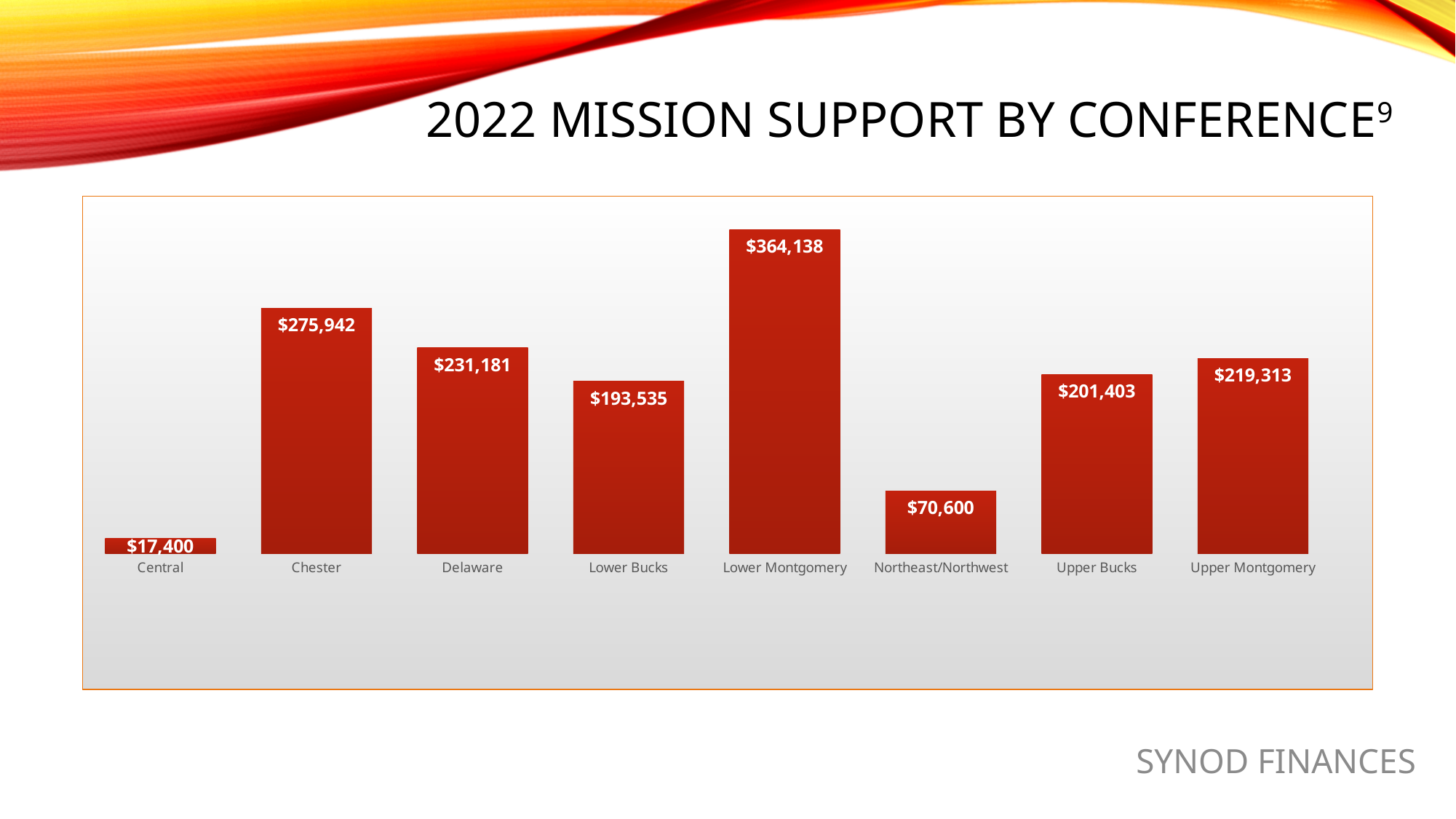
What is the 2022 mission support value for Upper Bucks? $201,403 What is the title of the slide containing the chart? 2022 Mission Support by Conference What is the difference in mission support between Delaware and Lower Bucks? $37,646 Which has higher mission support, Upper Montgomery or Upper Bucks? Upper Montgomery Which conference has the highest 2022 mission support? Lower Montgomery What is the 2022 mission support value for Lower Montgomery? $364,138 How many conferences are shown in the chart? 8 What kind of chart is shown on the slide? Bar chart Which conference has the lowest 2022 mission support? Central What is the 2022 mission support value for Northeast/Northwest? $70,600 What is the 2022 mission support value for Central? $17,400 What is the difference in mission support between Lower Montgomery and Chester? $88,196